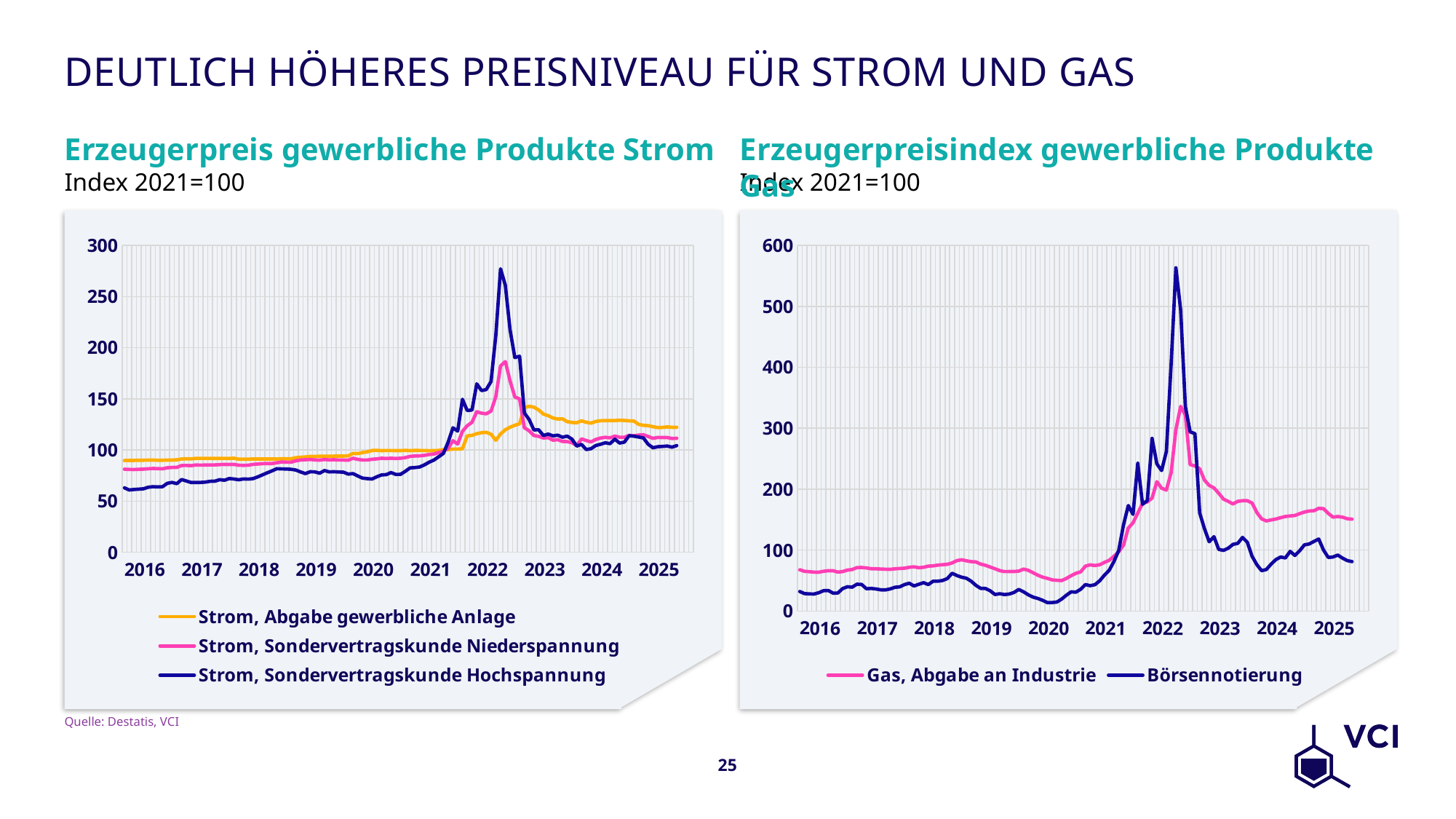
In the left chart, 'Erzeugerpreis gewerbliche Produkte Strom', is the peak value of 'Strom, Sondervertragskunde Hochspannung' greater or less than 250? greater In the left chart, 'Erzeugerpreis gewerbliche Produkte Strom', is the value of 'Strom, Sondervertragskunde Hochspannung' at the start of 2016 greater or less than 100? less In the right chart, 'Erzeugerpreisindex gewerbliche Produkte Gas', which series reaches the highest peak? Börsennotierung In the left chart, 'Erzeugerpreis gewerbliche Produkte Strom', which series reaches the highest peak? Strom, Sondervertragskunde Hochspannung What source is cited for the charts on the slide? Destatis, VCI How many series does the legend of the right chart, 'Erzeugerpreisindex gewerbliche Produkte Gas', list? 2 What kind of chart is the left chart, 'Erzeugerpreis gewerbliche Produkte Strom'? Line chart What index base year is stated under both chart titles? Index 2021=100 In the right chart, 'Erzeugerpreisindex gewerbliche Produkte Gas', is the peak value of 'Börsennotierung' greater or less than 500? greater How many series does the legend of the left chart, 'Erzeugerpreis gewerbliche Produkte Strom', list? 3 In the right chart, 'Erzeugerpreisindex gewerbliche Produkte Gas', does 'Gas, Abgabe an Industrie' rise or fall from its 2022 peak to 2025? fall